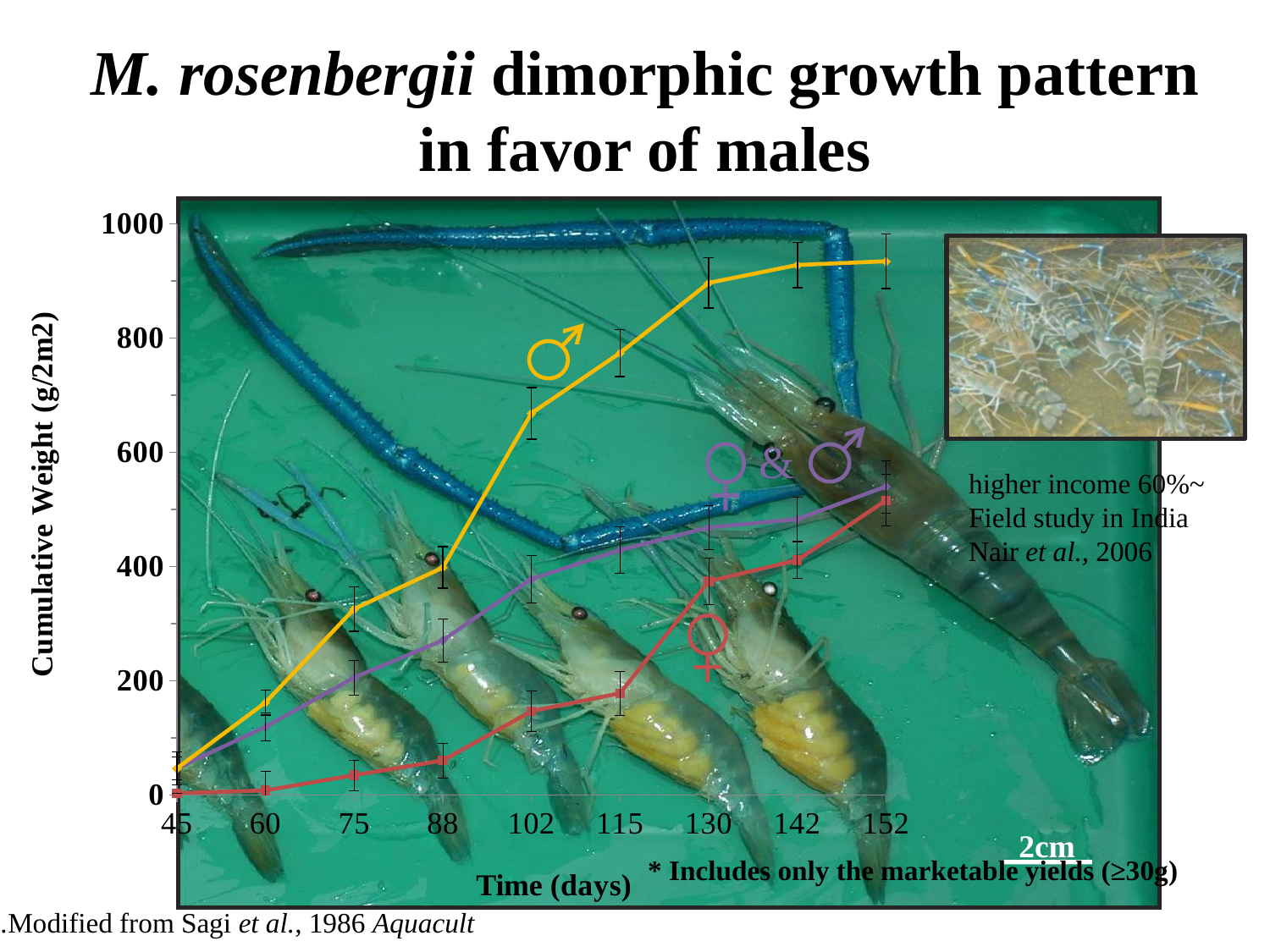
Is the cumulative weight for the female (red) line at 102 days greater or less than 200? less What kind of chart is shown on the slide? line chart Is the cumulative weight for the male (yellow) line at 152 days greater or less than 800? greater How many time points are marked on the x axis of the chart? 9 At 102 days, which line has the larger cumulative weight: the male (yellow) line or the female (red) line? male (yellow) Which line reaches the highest cumulative weight at 152 days? male (yellow) Is the cumulative weight for the male (yellow) line at 102 days greater or less than 600? greater What is the label of the y axis? Cumulative Weight (g/2m2) How many lines (series) are plotted on the chart? 3 What is the label of the x axis? Time (days) Does the cumulative weight for the male (yellow) line rise or fall as time increases from 45 to 152 days? rise